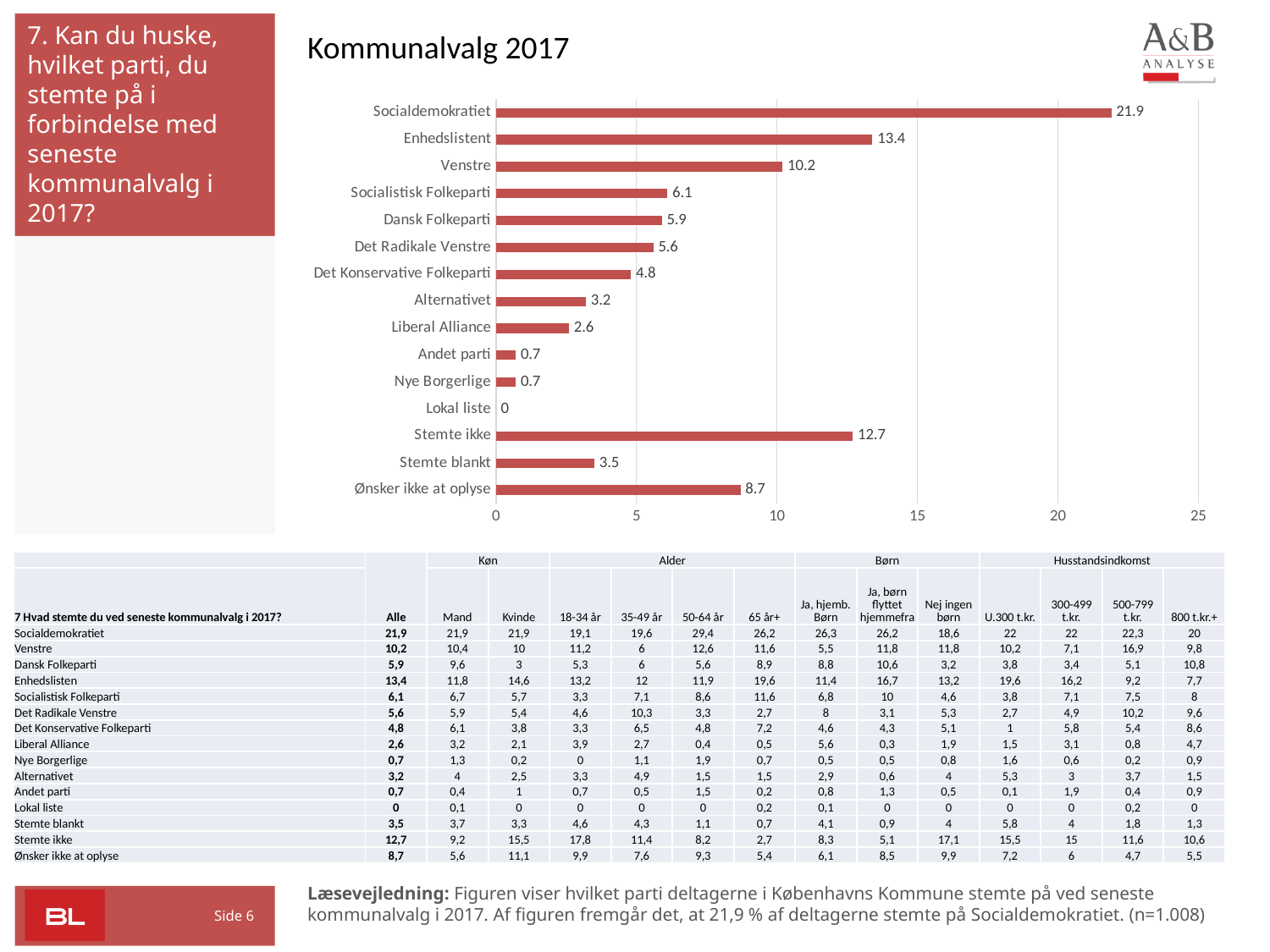
How many categories are shown in the Kommunalvalg 2017 chart? 15 What kind of chart is the Kommunalvalg 2017 chart? Bar chart What is the value for Det Konservative Folkeparti in the Kommunalvalg 2017 chart? 4.8 What is the title of the chart on the slide? Kommunalvalg 2017 What is the difference between the values for Socialdemokratiet and Enhedslisten in the Kommunalvalg 2017 chart? 8.5 What is the value for Socialdemokratiet in the Kommunalvalg 2017 chart? 21.9 What is the difference between the values for Enhedslisten and Venstre in the Kommunalvalg 2017 chart? 3.2 What is the value for Stemte ikke in the Kommunalvalg 2017 chart? 12.7 Which category has the highest value in the Kommunalvalg 2017 chart? Socialdemokratiet Is the value for Enhedslisten in the Kommunalvalg 2017 chart greater or less than 10? greater Which category has the lowest value in the Kommunalvalg 2017 chart? Lokal liste Which is larger in the Kommunalvalg 2017 chart, the value for Stemte ikke or the value for Ønsker ikke at oplyse? Stemte ikke